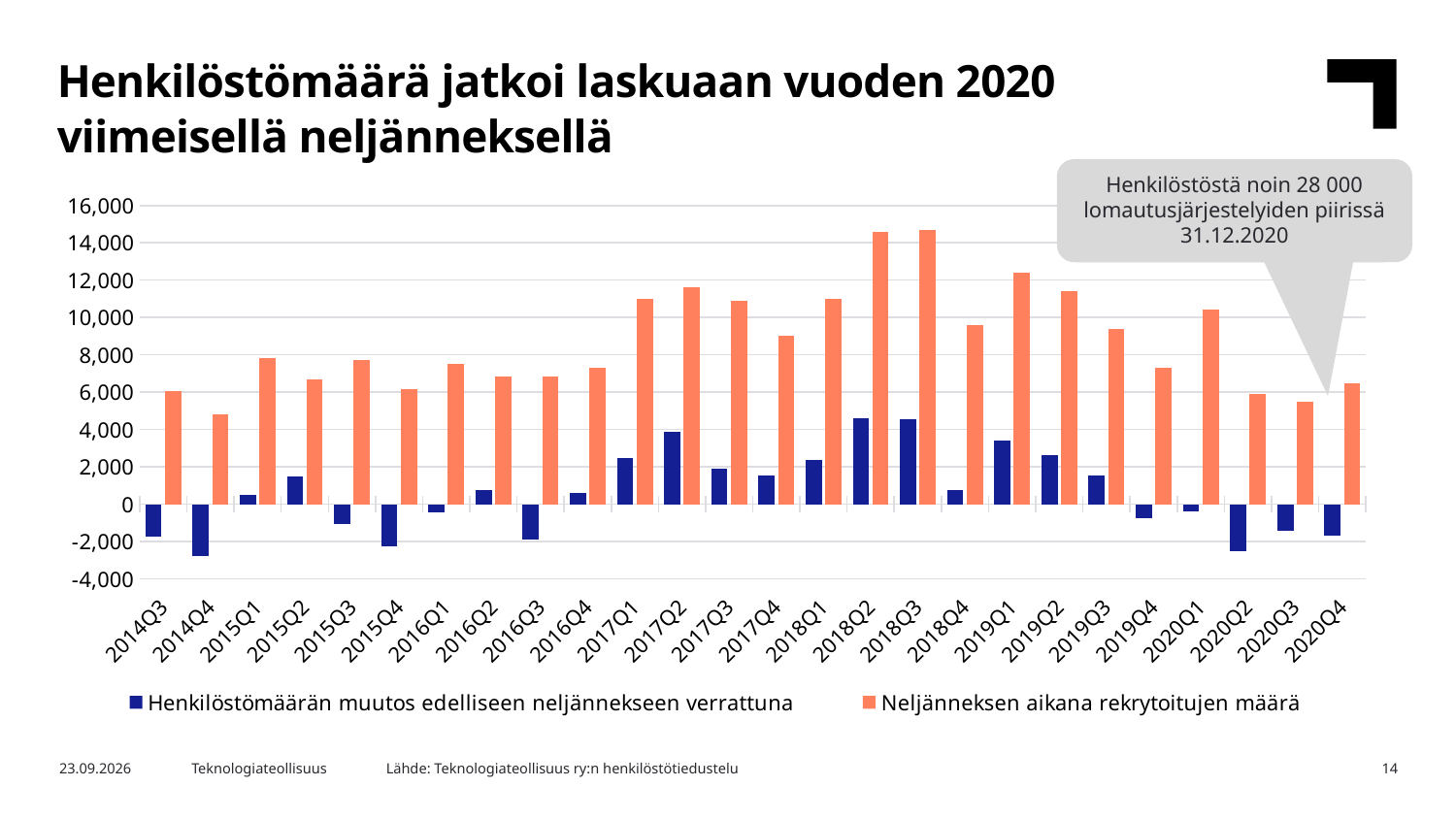
According to the callout on the chart, about how many employees were covered by lay-off arrangements on 31.12.2020? noin 28 000 What kind of chart is shown on the slide? bar chart How many series does the legend list? 2 Is the value for Neljänneksen aikana rekrytoitujen määrä in 2020Q4 greater or less than 6,000? greater Is the value for Henkilöstömäärän muutos edelliseen neljännekseen verrattuna in 2019Q1 greater or less than 2,000? greater How many quarters are shown on the x axis? 26 Is the value for Henkilöstömäärän muutos edelliseen neljännekseen verrattuna in 2020Q2 greater or less than -2,000? less From 2019Q1 to 2019Q4, does the value for Neljänneksen aikana rekrytoitujen määrä rise or fall? fall Which quarter has the larger value for Neljänneksen aikana rekrytoitujen määrä, 2017Q2 or 2017Q3? 2017Q2 Which quarter has the lowest value for Neljänneksen aikana rekrytoitujen määrä? 2014Q4